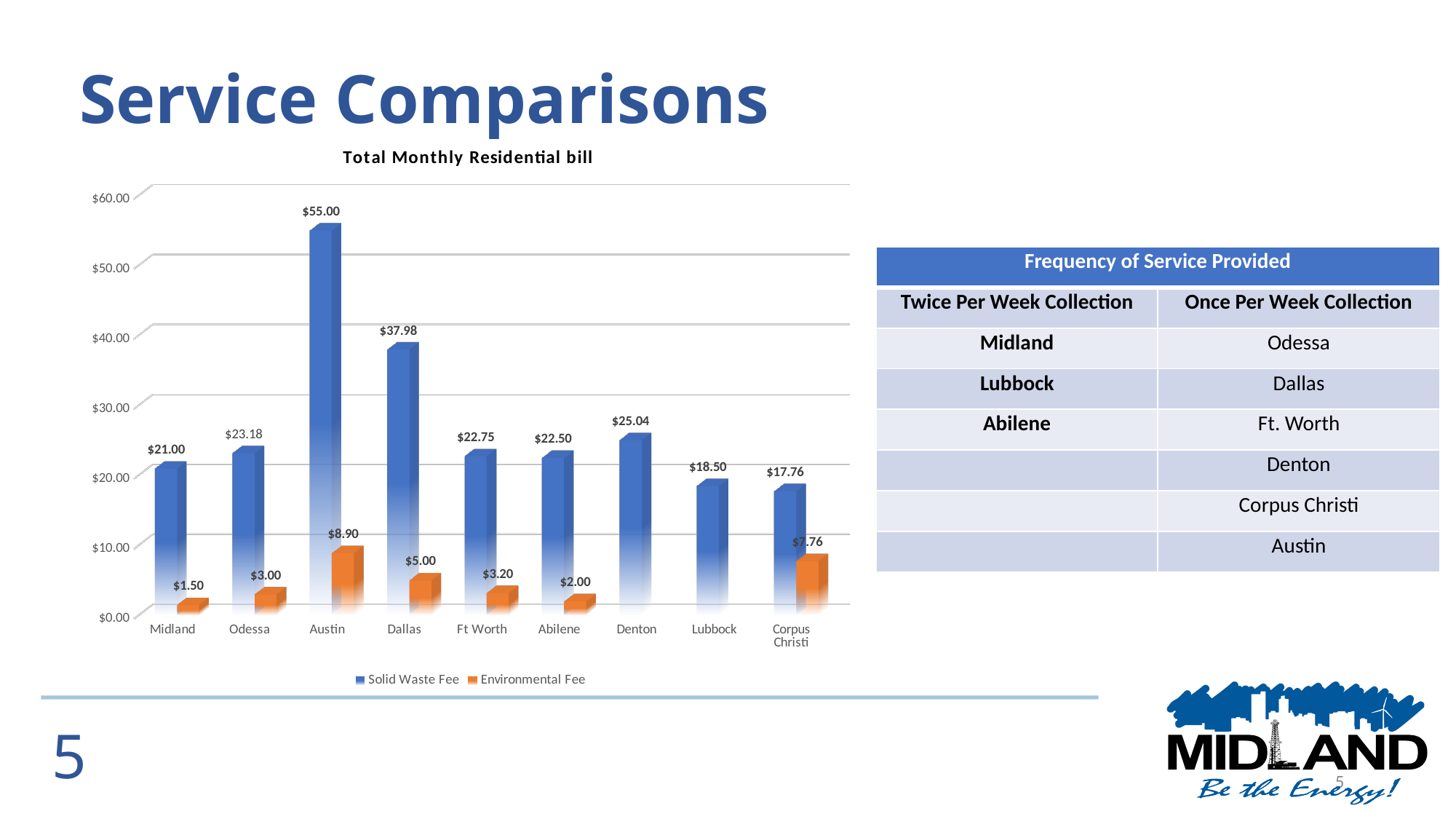
Which is larger, the Solid Waste Fee for Denton or for Odessa? Denton Which city has the highest Solid Waste Fee? Austin Which city has the lowest Environmental Fee among those shown? Midland What type of chart is used to show the Total Monthly Residential bill? Bar chart What is the difference between the Solid Waste Fee for Austin and for Dallas? $17.02 What is the Solid Waste Fee for Midland? $21.00 Which city has the lowest Solid Waste Fee? Corpus Christi What is the Solid Waste Fee for Austin? $55.00 How many cities are shown on the x axis of the chart? 9 How many series does the chart legend list? 2 What is the Environmental Fee for Corpus Christi? $7.76 Is the Solid Waste Fee for Lubbock greater or less than $20.00? less